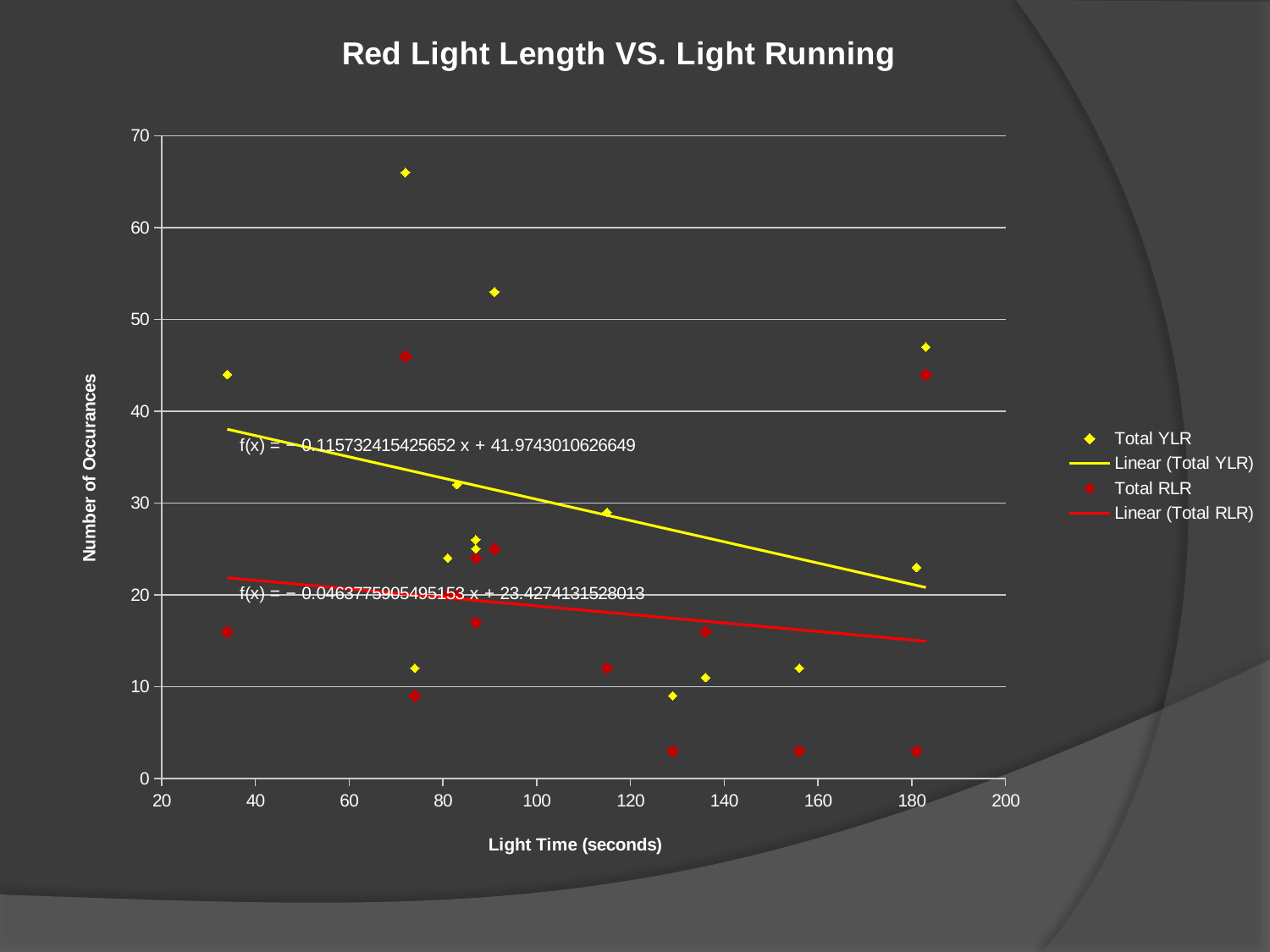
How many entries does the legend list? 4 Is the highest Total RLR point greater or less than 40? greater Does the Linear (Total RLR) trendline rise or fall as Light Time increases? Fall Is the highest Total YLR point greater or less than 60? greater What is the label on the x axis? Light Time (seconds) Which series has the higher trendline across the chart, Total YLR or Total RLR? Total YLR What kind of chart is shown on the slide? Scatter chart Are the lowest Total RLR points greater or less than 10? less Which series contains the lowest points on the chart? Total RLR Does the Linear (Total YLR) trendline rise or fall as Light Time increases? Fall Which series contains the single highest point on the chart? Total YLR What is the title of the chart? Red Light Length VS. Light Running